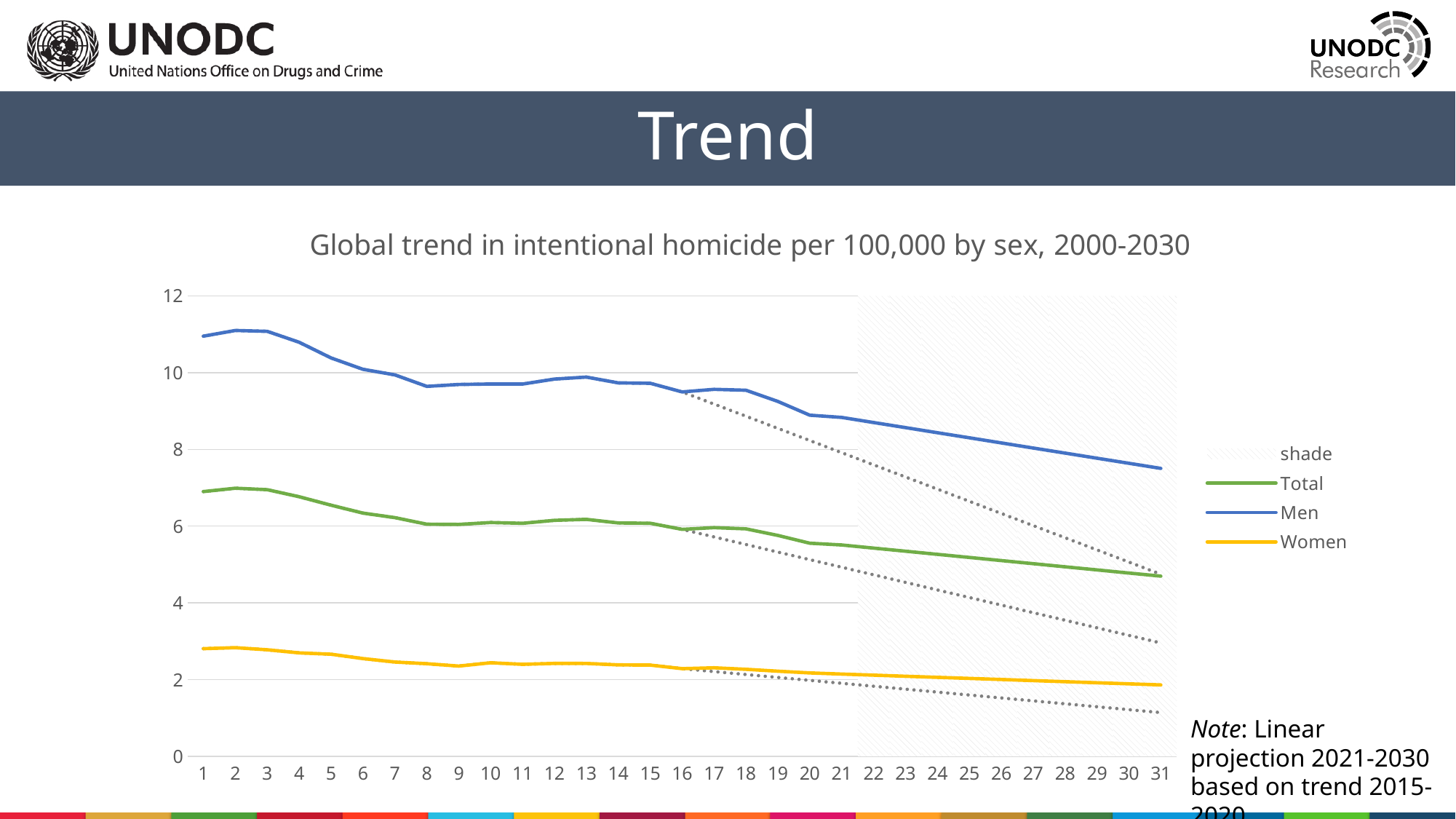
How many entries does the chart's legend list? 4 Is the value for Women at point 1 greater or less than 2? greater Is the value for Total at point 31 greater or less than 6? less Which is larger at point 1, the value for Men or the value for Total? Men Do the values for Men generally rise or fall from point 1 to point 31? fall Is the value for Men at point 31 greater or less than 8? less Which series has the lowest values throughout the chart? Women Which series has the highest values throughout the chart? Men What is the title of the chart? Global trend in intentional homicide per 100,000 by sex, 2000-2030 How many points are labelled along the x axis of the chart? 31 What kind of chart is shown on the slide? line chart